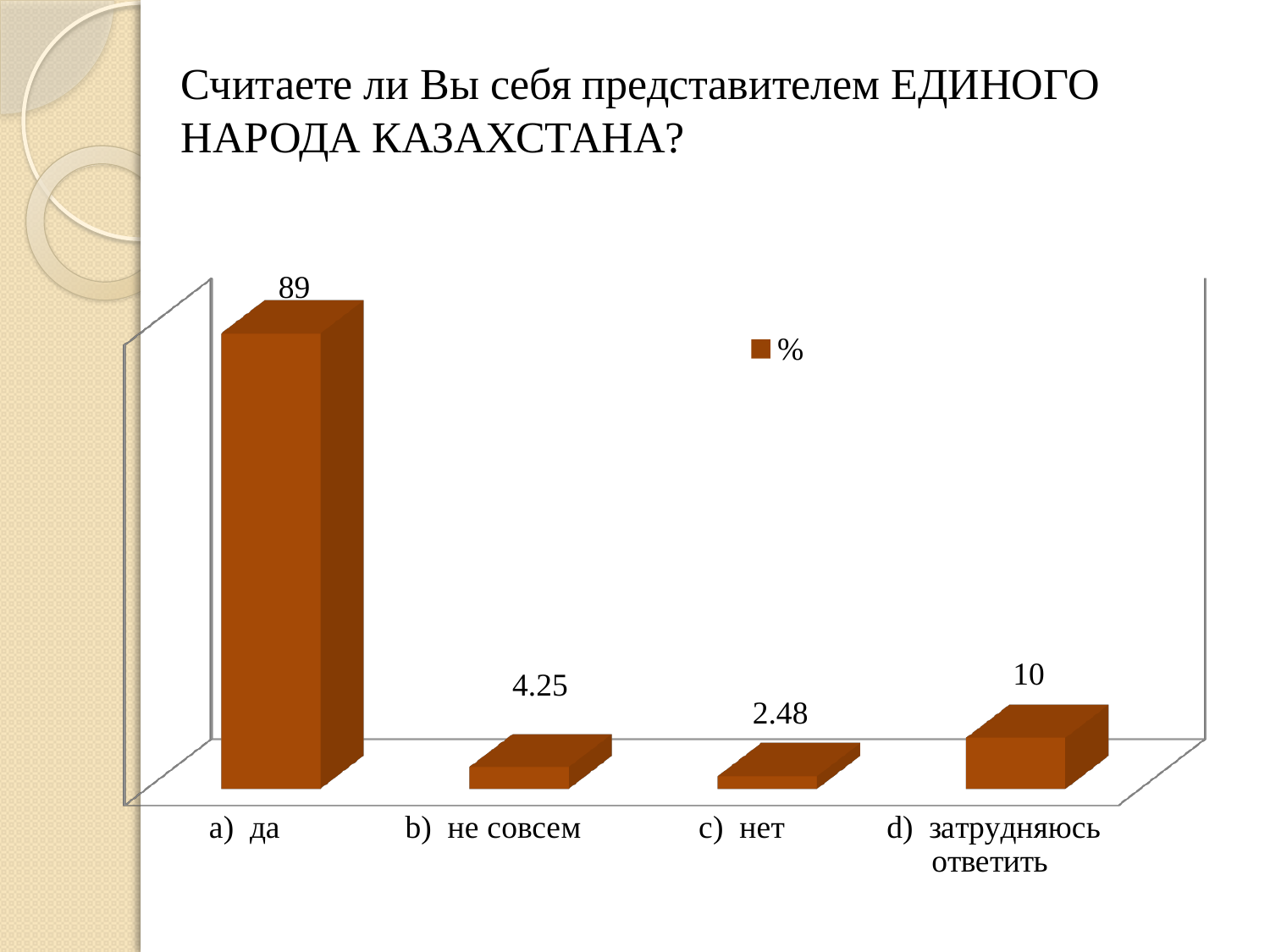
How many categories are shown on the chart? 4 Which category has the highest value? a) да What is the difference between the values for "a) да" and "d) затрудняюсь ответить"? 79 What is the value for "b) не совсем"? 4.25 What is the value for "d) затрудняюсь ответить"? 10 What is the value for "c) нет"? 2.48 How many series does the legend list? 1 What is the difference between the values for "b) не совсем" and "c) нет"? 1.77 Which category has the lowest value? c) нет What is the value for "a) да"? 89 What kind of chart is shown on the slide? bar chart Which is larger, the value for "d) затрудняюсь ответить" or the value for "b) не совсем"? d) затрудняюсь ответить